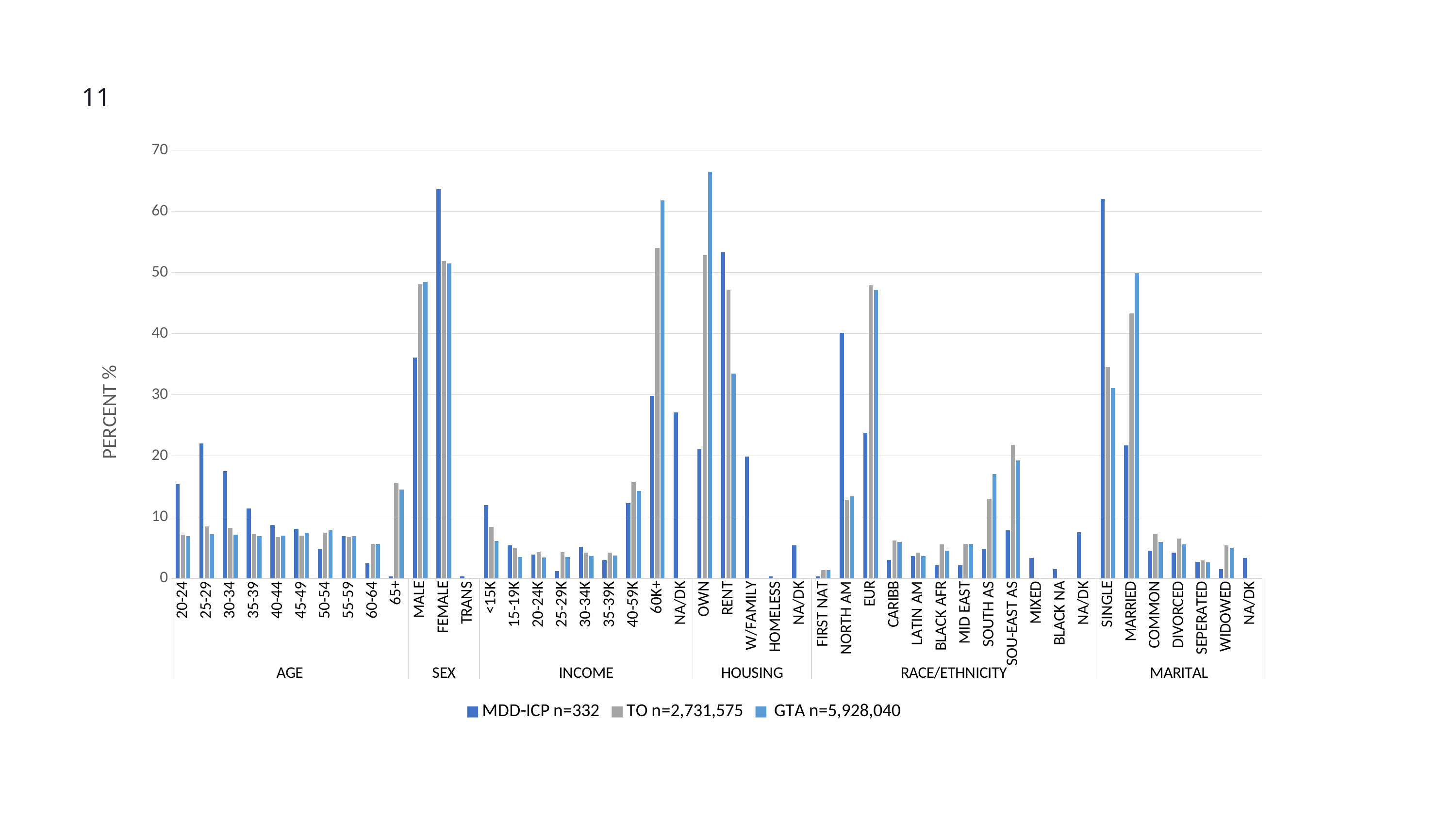
How many categories are shown in the MARITAL group? 7 How many age categories are shown in the AGE group? 10 How many series does the legend list? 3 What is the label on the vertical axis? PERCENT % Within the AGE group, which category has the highest MDD-ICP n=332 value? 25-29 Is the MDD-ICP n=332 value for MALE greater or less than 30? greater For OWN, which is larger: the MDD-ICP n=332 value or the GTA n=5,928,040 value? GTA n=5,928,040 For SINGLE, which is larger: the MDD-ICP n=332 value or the GTA n=5,928,040 value? MDD-ICP n=332 Is the MDD-ICP n=332 value for FEMALE greater or less than 60? greater Is the GTA n=5,928,040 value for OWN greater or less than 60? greater What kind of chart is shown on the slide? bar chart